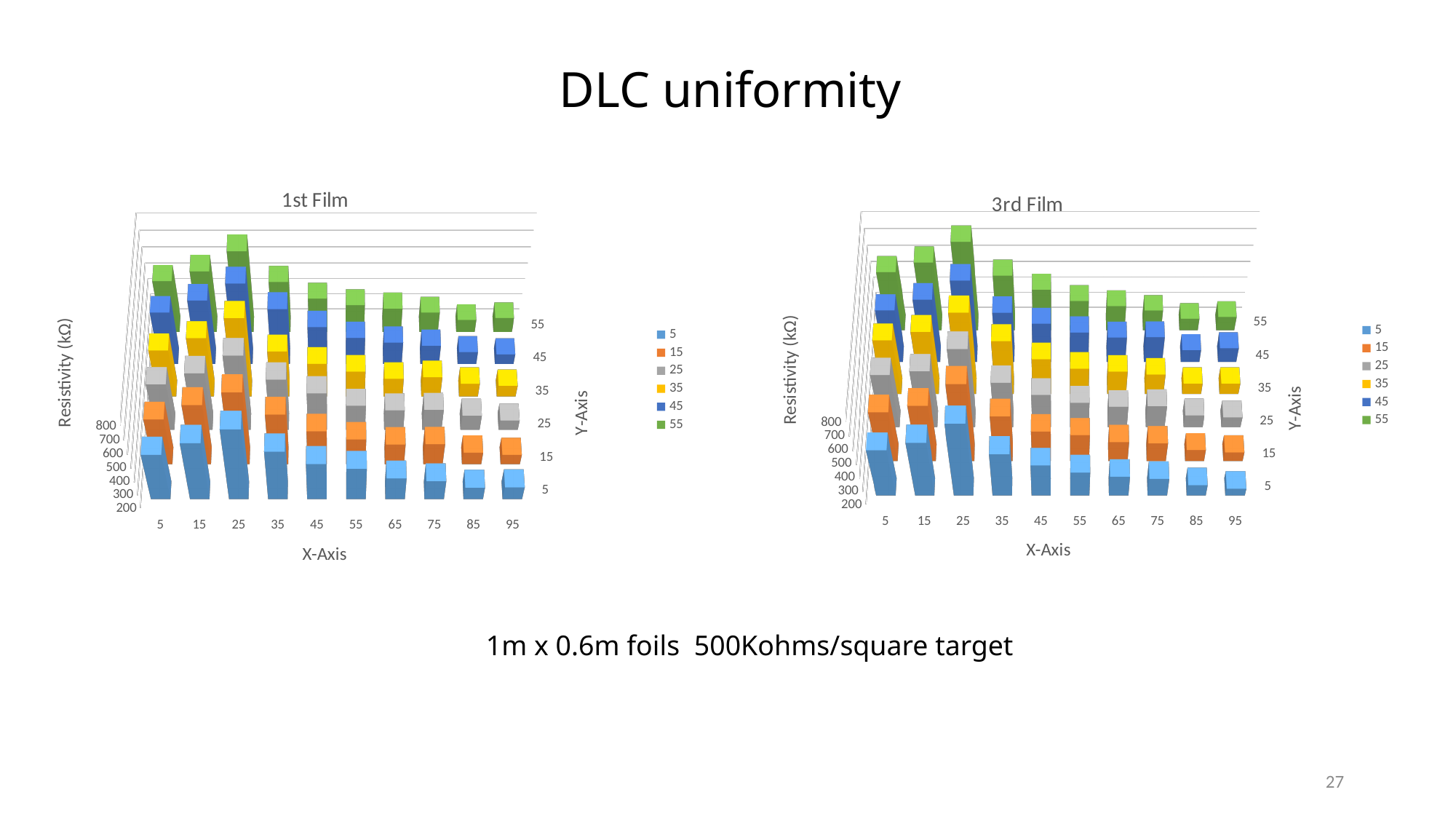
How many series does the legend of the 1st Film chart list? 6 In the 1st Film chart, which X-Axis category has the tallest bars? 25 What kind of chart is the 1st Film chart? bar chart How many categories are shown along the X-Axis of the 3rd Film chart? 10 In the 3rd Film chart, which X-Axis category has the tallest bars? 25 What is the vertical axis label of the 1st Film chart? Resistivity (kΩ) What kind of chart is the 3rd Film chart? bar chart In the 1st Film chart, do the bar heights rise or fall along the X-Axis from 25 to 95? fall How many series does the legend of the 3rd Film chart list? 6 How many categories are shown along the X-Axis of the 1st Film chart? 10 In the 3rd Film chart, do the bar heights rise or fall along the X-Axis from 25 to 95? fall What are the titles of the two charts on the slide? 1st Film and 3rd Film